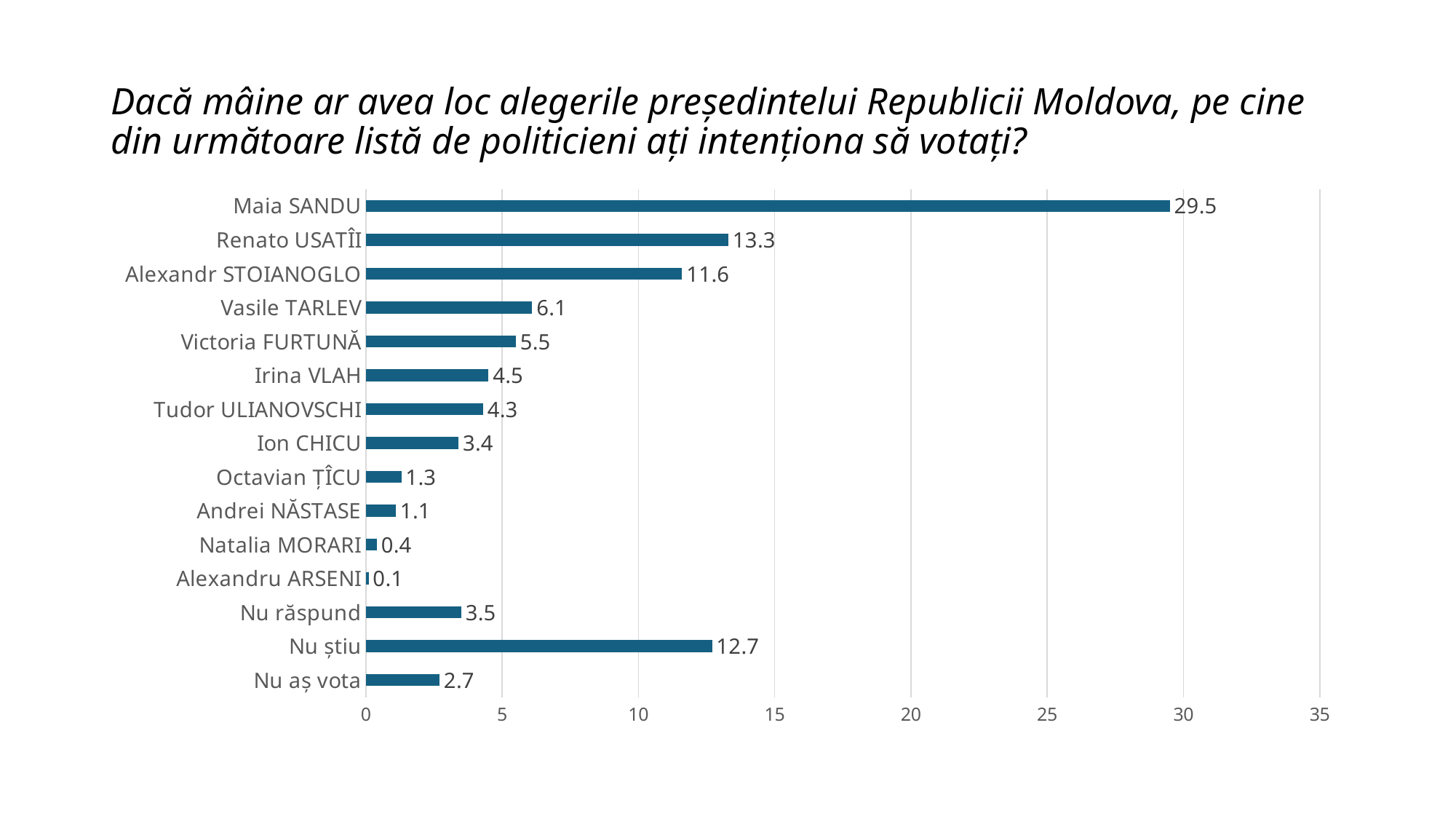
Is the value for Vasile TARLEV greater or less than 5? greater What kind of chart is shown on the slide? bar chart What is the value for Nu știu? 12.7 How many categories are shown on the chart? 15 What is the value for Alexandru ARSENI? 0.1 What is the difference between the values for Irina VLAH and Tudor ULIANOVSCHI? 0.2 What is the difference between the values for Maia SANDU and Renato USATÎI? 16.2 What is the value for Renato USATÎI? 13.3 Which category has the highest value? Maia SANDU Which is larger, the value for Alexandr STOIANOGLO or the value for Nu știu? Nu știu Which category has the lowest value? Alexandru ARSENI What is the value for Maia SANDU? 29.5